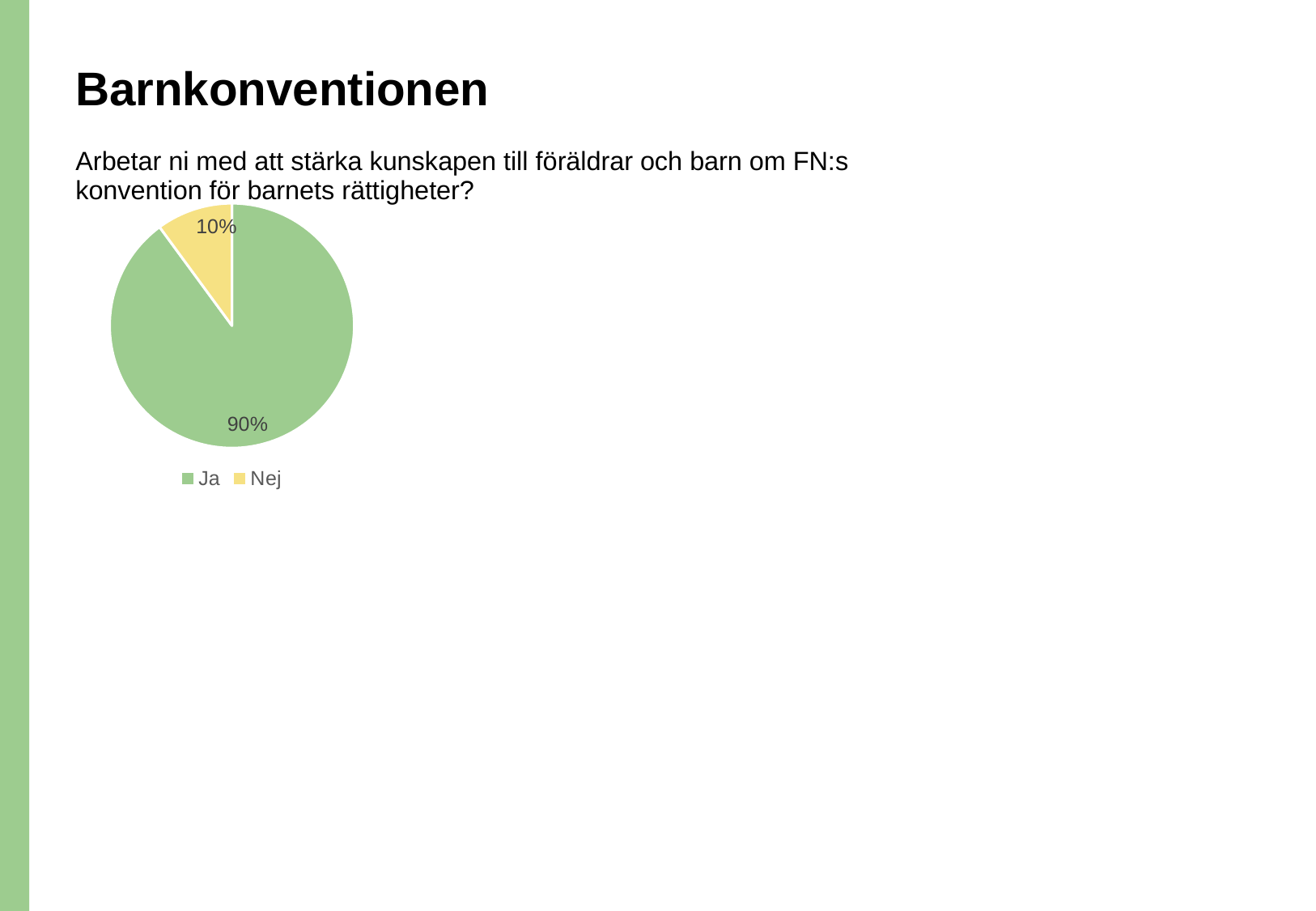
What share of the pie does "Nej" represent? 10% What is the difference in percentage points between the "Ja" and "Nej" slices? 80 How many slices does the pie chart have? 2 What kind of chart is shown on the slide? pie chart What colour is the "Ja" slice? green Which category has the smallest slice of the pie? Nej How many entries does the legend list? 2 What colour is the "Nej" slice? yellow Which is larger, the "Ja" slice or the "Nej" slice? Ja What share of the pie does "Ja" represent? 90% Which category has the largest slice of the pie? Ja